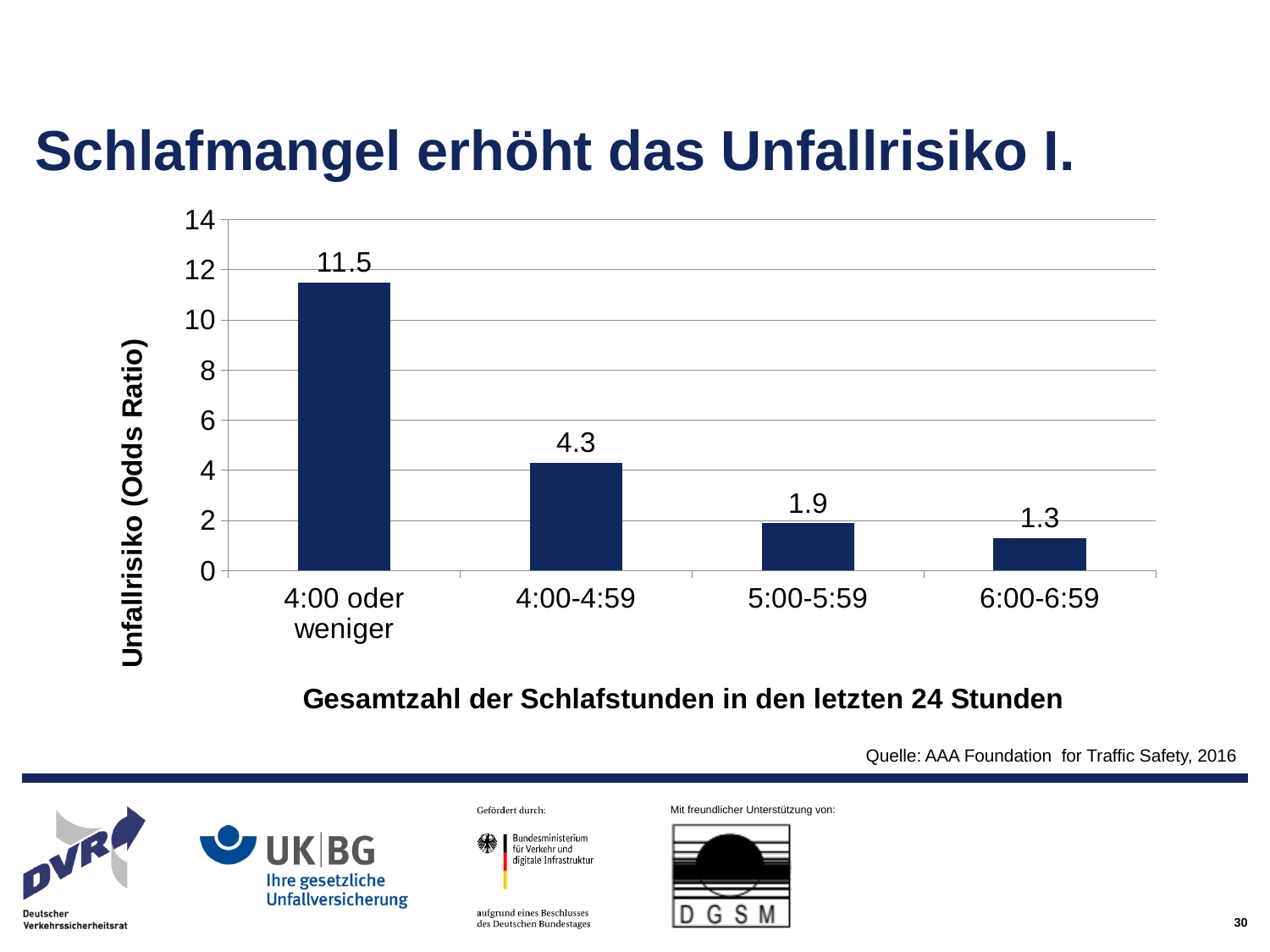
Which is larger, the Odds Ratio for "4:00-4:59" or for "5:00-5:59"? 4:00-4:59 What is the Unfallrisiko (Odds Ratio) for the category "6:00-6:59"? 1.3 Do the values rise or fall as the number of sleep hours increases along the x axis? fall What is the Unfallrisiko (Odds Ratio) for the category "5:00-5:59"? 1.9 Is the value for "4:00-4:59" greater or less than 6? less Which category has the lowest Unfallrisiko (Odds Ratio)? 6:00-6:59 What is the label of the x axis of the chart? Gesamtzahl der Schlafstunden in den letzten 24 Stunden How many categories are shown on the x axis of the chart? 4 Which category has the highest Unfallrisiko (Odds Ratio)? 4:00 oder weniger What kind of chart is shown on the slide? bar chart What is the difference between the Odds Ratio for "4:00 oder weniger" and for "4:00-4:59"? 7.2 What is the Unfallrisiko (Odds Ratio) for the category "4:00 oder weniger"? 11.5